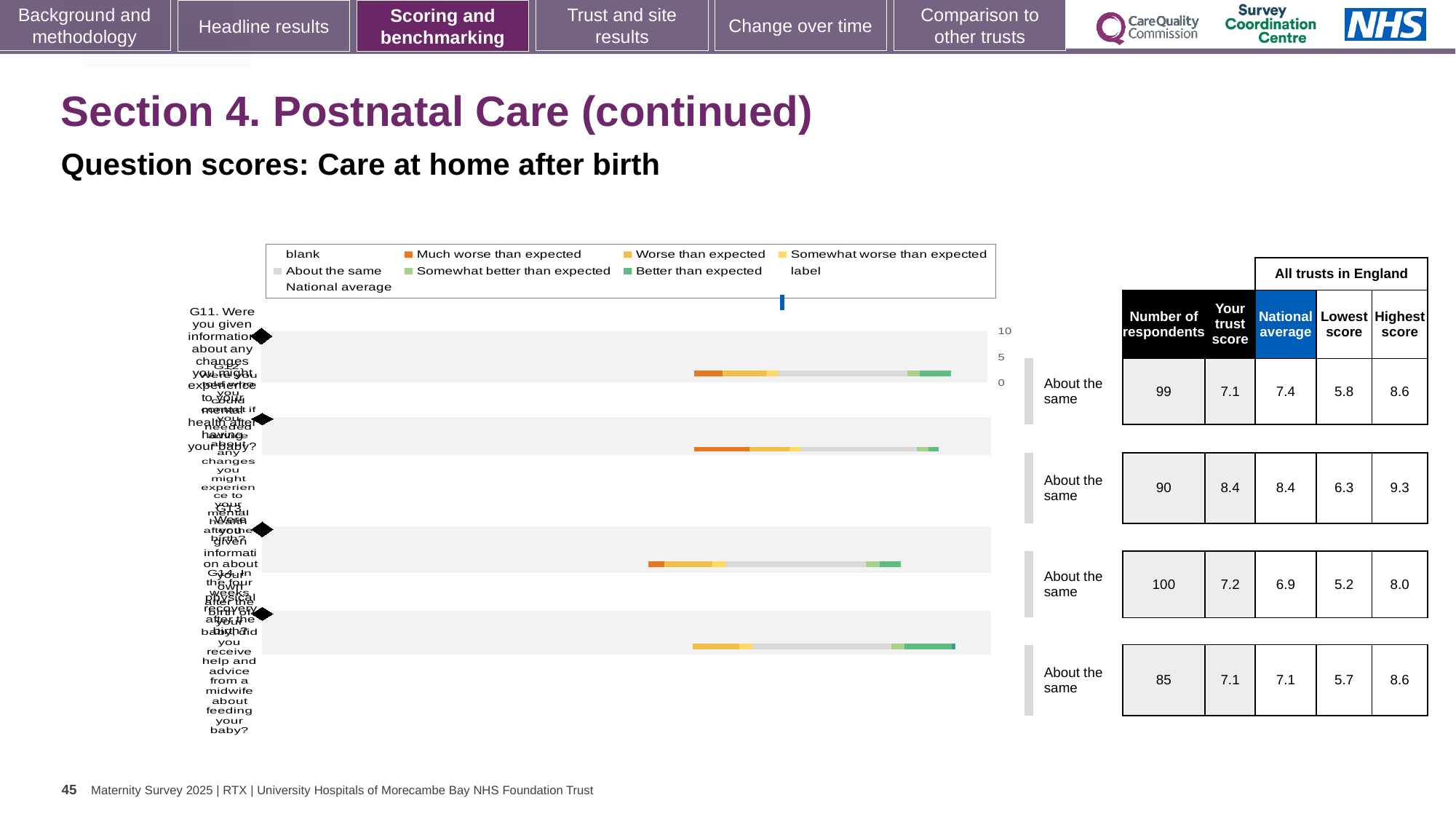
Which question row has the highest number of respondents in the table beside the chart? the third row (100) In the table beside the chart, what is the trust score for the first question (G11)? 7.1 What kind of chart is shown on the slide? bar chart For the first question (G11), what is the difference between the national average and the trust score? 0.3 In the table beside the chart, what is the highest score across all trusts in England for the third question row? 8.0 For the third question row, is the trust score or the national average larger? trust score Which question row has the lowest number of respondents in the table beside the chart? the fourth row (85) In the table beside the chart, what is the national average for the second question row? 8.4 In the table beside the chart, what is the number of respondents for the first question (G11)? 99 In the table beside the chart, what is the lowest score across all trusts in England for the fourth question row? 5.7 How many question bars are plotted in the chart? 4 What is the highest tick value shown on the chart's score axis? 10